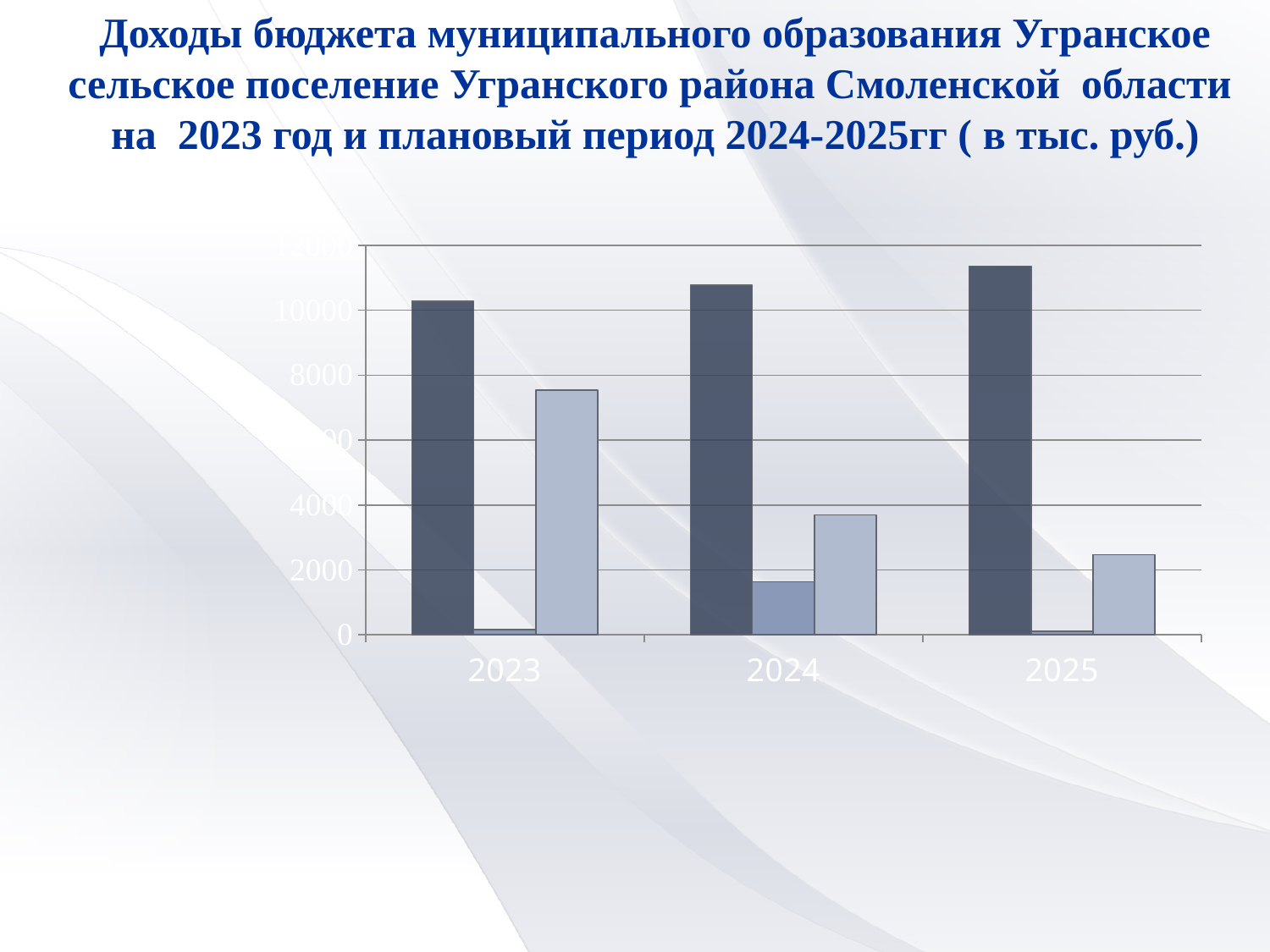
Do the values of the light-blue bars rise or fall from 2023 to 2025? fall Is the value of the dark bar for 2023 greater or less than 8000? greater How many years (categories) are shown on the x axis of the chart? 3 What kind of chart is shown on the slide? bar chart Is the value of the light-blue bar for 2024 greater or less than 4000? less How many bars are plotted for each year in the chart? 3 Is the value of the tallest (dark) bar for 2025 greater or less than 10000? greater Which is larger: the light-blue bar for 2023 or the light-blue bar for 2024? 2023 In which year is the dark bar the tallest? 2025 In which year is the light-blue bar the shortest? 2025